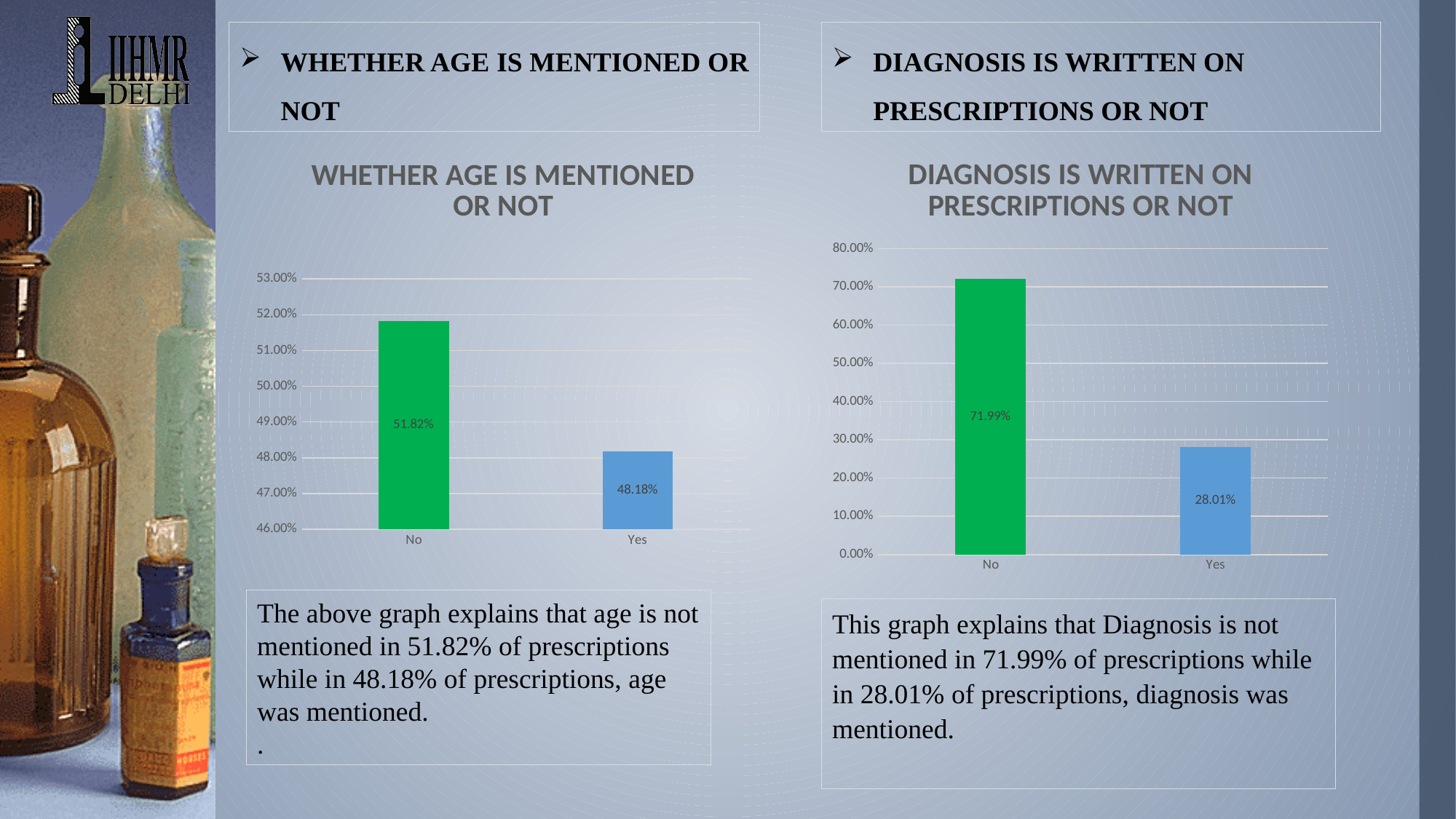
In the chart titled 'DIAGNOSIS IS WRITTEN ON PRESCRIPTIONS OR NOT', is the value for 'Yes' greater or less than 30.00%? less In the chart titled 'DIAGNOSIS IS WRITTEN ON PRESCRIPTIONS OR NOT', which category has the lowest value? Yes In the chart titled 'DIAGNOSIS IS WRITTEN ON PRESCRIPTIONS OR NOT', what is the value for 'Yes'? 28.01% What kind of chart is the chart titled 'DIAGNOSIS IS WRITTEN ON PRESCRIPTIONS OR NOT'? Bar chart How many categories are shown in the chart titled 'WHETHER AGE IS MENTIONED OR NOT'? 2 In the chart titled 'WHETHER AGE IS MENTIONED OR NOT', what is the value for 'Yes'? 48.18% In the chart titled 'DIAGNOSIS IS WRITTEN ON PRESCRIPTIONS OR NOT', what is the difference between the values for 'No' and 'Yes'? 43.98% In the chart titled 'WHETHER AGE IS MENTIONED OR NOT', which category has the highest value? No In the chart titled 'WHETHER AGE IS MENTIONED OR NOT', what is the value for 'No'? 51.82% In the chart titled 'DIAGNOSIS IS WRITTEN ON PRESCRIPTIONS OR NOT', what is the value for 'No'? 71.99% In the chart titled 'WHETHER AGE IS MENTIONED OR NOT', what colour is the bar for 'Yes'? Blue In the chart titled 'WHETHER AGE IS MENTIONED OR NOT', what is the difference between the values for 'No' and 'Yes'? 3.64%